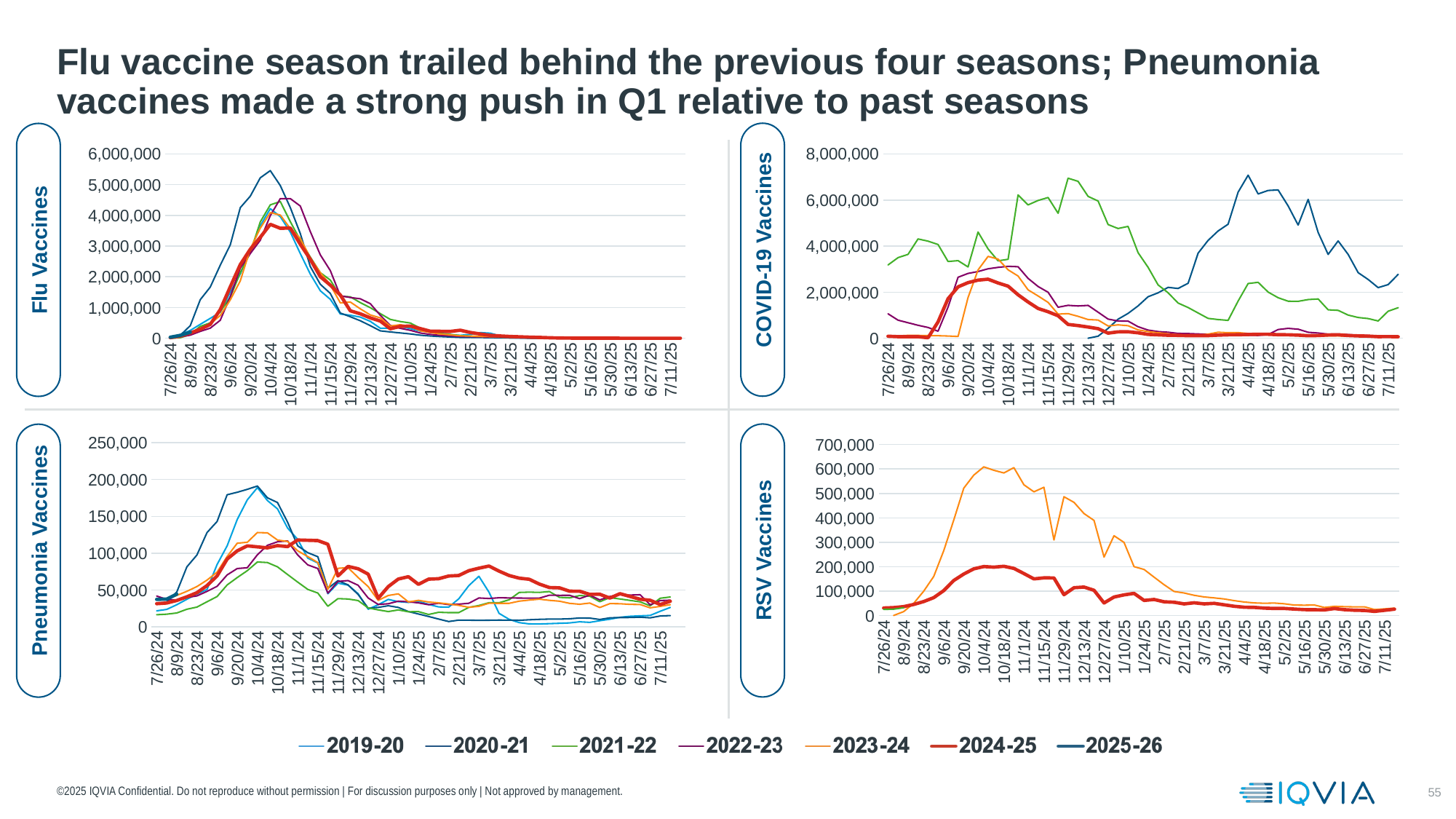
In the Flu Vaccines chart, is the peak value for 2020-21 greater or less than 5,000,000? greater In the COVID-19 Vaccines chart, is the peak value for 2021-22 greater or less than 6,000,000? greater How many series does the legend list? 7 How many charts are shown on the slide? 4 In the RSV Vaccines chart, is the peak value for 2024-25 greater or less than 300,000? less What kind of chart is the Flu Vaccines chart? line chart In the RSV Vaccines chart, at 10/4/24, which is larger: 2023-24 or 2024-25? 2023-24 In the RSV Vaccines chart, which season has the highest peak? 2023-24 What is the highest value shown on the y axis of the Pneumonia Vaccines chart? 250,000 In the Flu Vaccines chart, which season has the highest peak? 2020-21 In the RSV Vaccines chart, does the 2023-24 line rise or fall from 10/18/24 to 7/11/25? fall